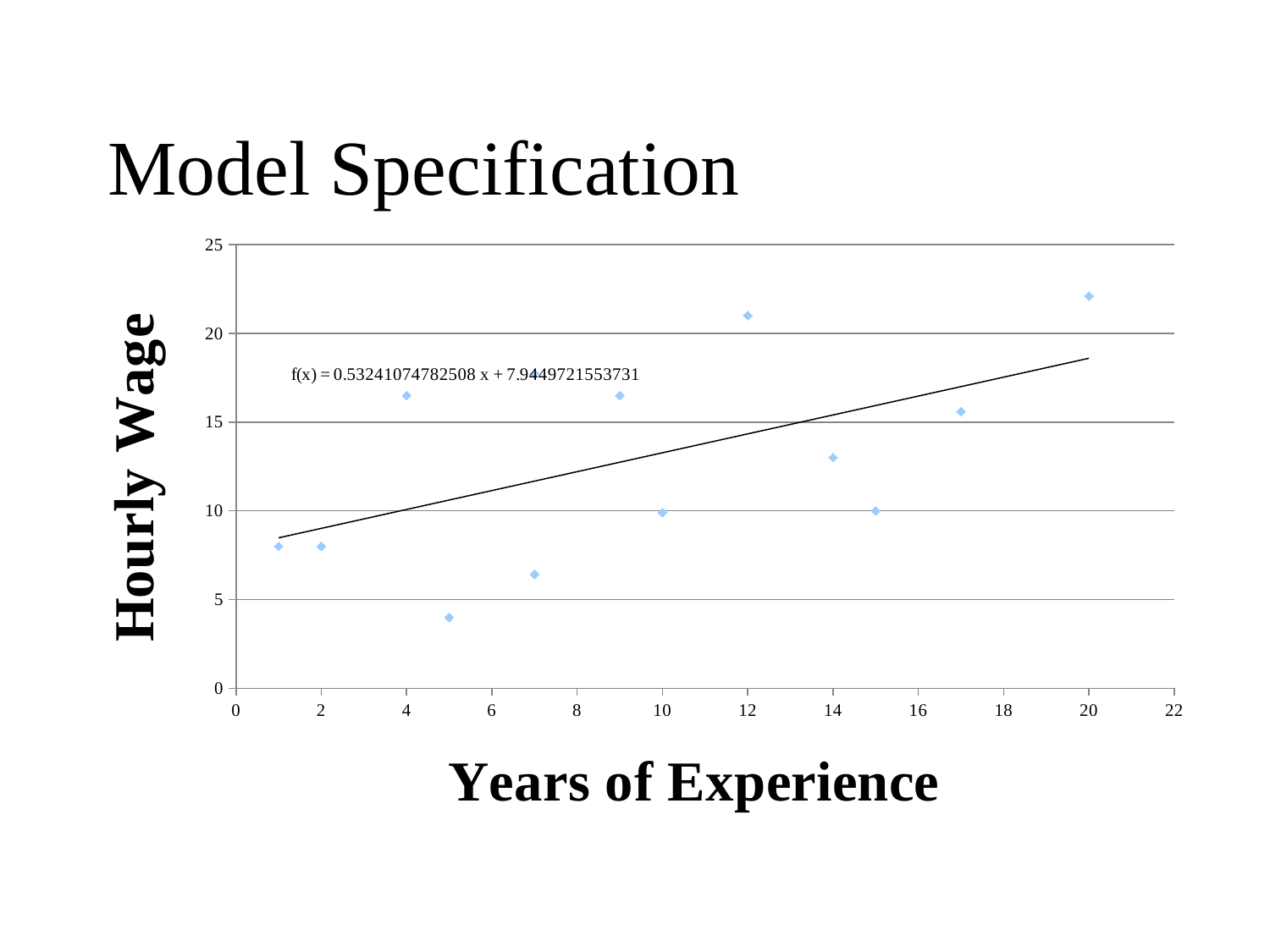
Which has the higher hourly wage: 4 years of experience or 14 years of experience? 4 years of experience What is the label of the vertical axis? Hourly Wage Is the hourly wage for 12 years of experience greater or less than 20? greater What is the trendline equation printed on the chart? f(x) = 0.53241074782508 x + 7.9449721553731 Is the hourly wage for 17 years of experience greater or less than 15? greater Is the hourly wage for 5 years of experience greater or less than 5? less What kind of chart is shown on the slide? Scatter plot Which has the higher hourly wage: 20 years of experience or 15 years of experience? 20 years of experience At which value of years of experience is the hourly wage lowest? 5 Does hourly wage generally rise or fall as years of experience increases, according to the trendline? Rise